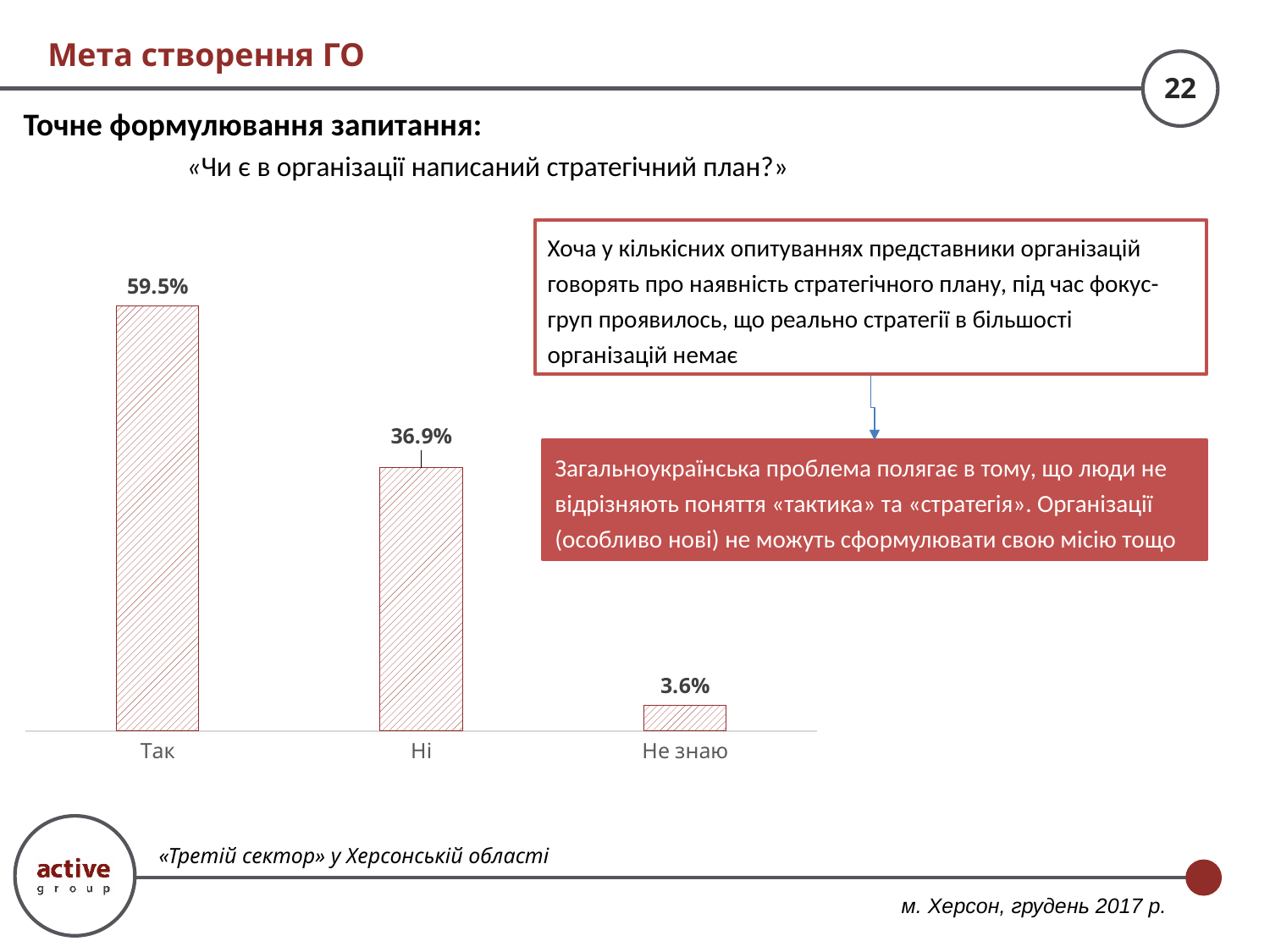
Which is larger, the value for "Ні" or the value for "Не знаю"? Ні Do the values rise or fall from left to right along the x axis? Fall What kind of chart is shown on the slide? Bar chart What is the value for the category "Не знаю"? 3.6% What is the value for the category "Ні"? 36.9% How many categories are shown in the chart? 3 Which category has the lowest value? Не знаю What survey question does the chart present? «Чи є в організації написаний стратегічний план?» What is the value for the category "Так"? 59.5% What is the difference between the values for "Так" and "Ні"? 22.6% Which category has the highest value? Так What is the difference between the values for "Ні" and "Не знаю"? 33.3%